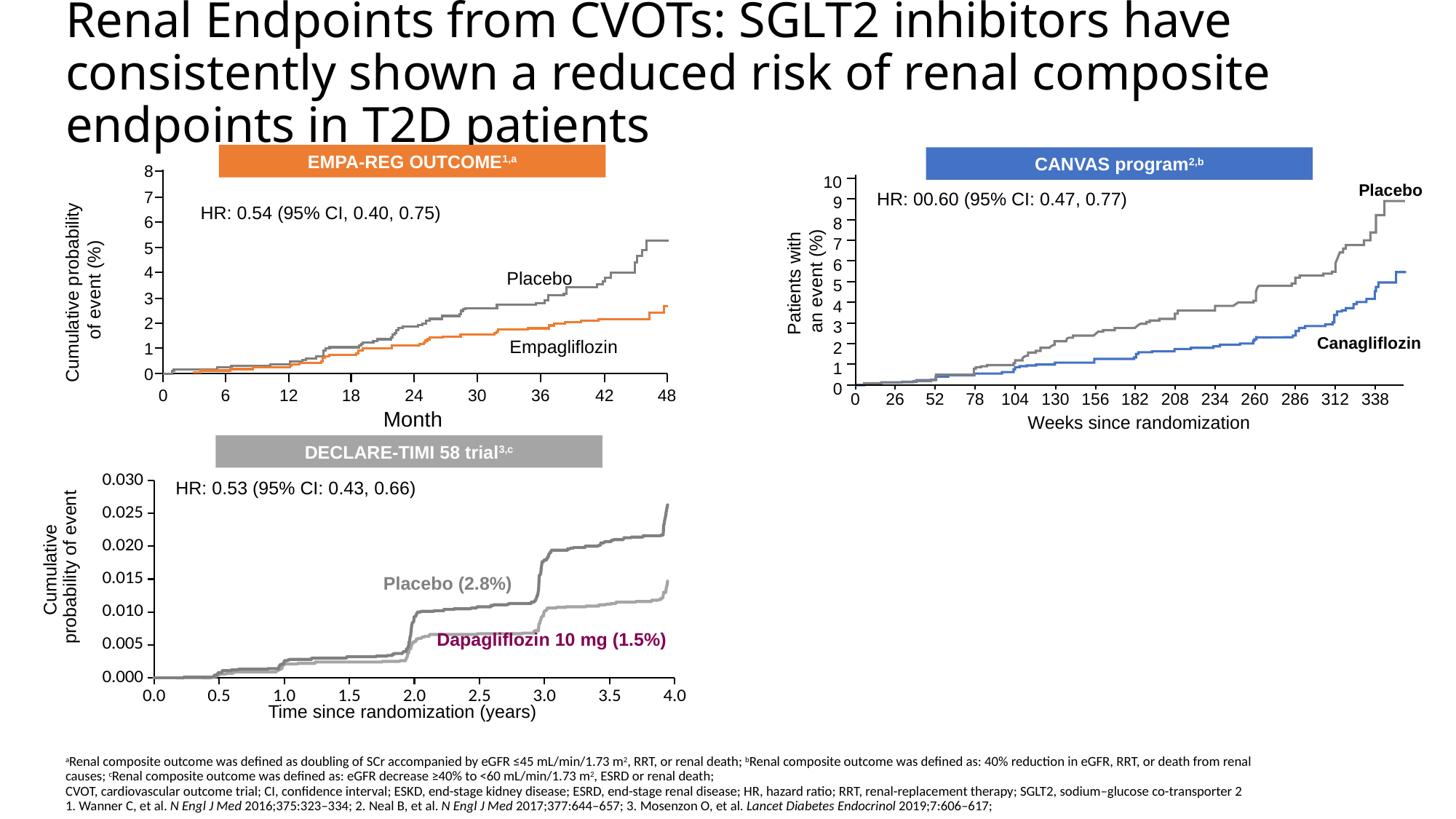
In the EMPA-REG OUTCOME chart, is the Empagliflozin value at 48 months greater or less than 3? less What is the x-axis label of the CANVAS program chart? Weeks since randomization In the DECLARE-TIMI 58 trial chart, does the Placebo curve rise or fall as time since randomization increases? Rises In the CANVAS program chart, is the Canagliflozin value at the end of follow-up greater or less than 6? less In the EMPA-REG OUTCOME chart, which group has the higher cumulative probability of event at 48 months, Placebo or Empagliflozin? Placebo In the CANVAS program chart, is the Placebo value at the end of follow-up greater or less than 8? greater In the DECLARE-TIMI 58 trial chart, what percentage is printed for the Placebo group? 2.8% In the DECLARE-TIMI 58 trial chart, what percentage is printed for Dapagliflozin 10 mg? 1.5% What hazard ratio is shown on the EMPA-REG OUTCOME chart? HR: 0.54 (95% CI, 0.40, 0.75) What kind of chart is the EMPA-REG OUTCOME chart? Line chart In the DECLARE-TIMI 58 trial chart, what is the difference between the Placebo percentage and the Dapagliflozin 10 mg percentage? 1.3%